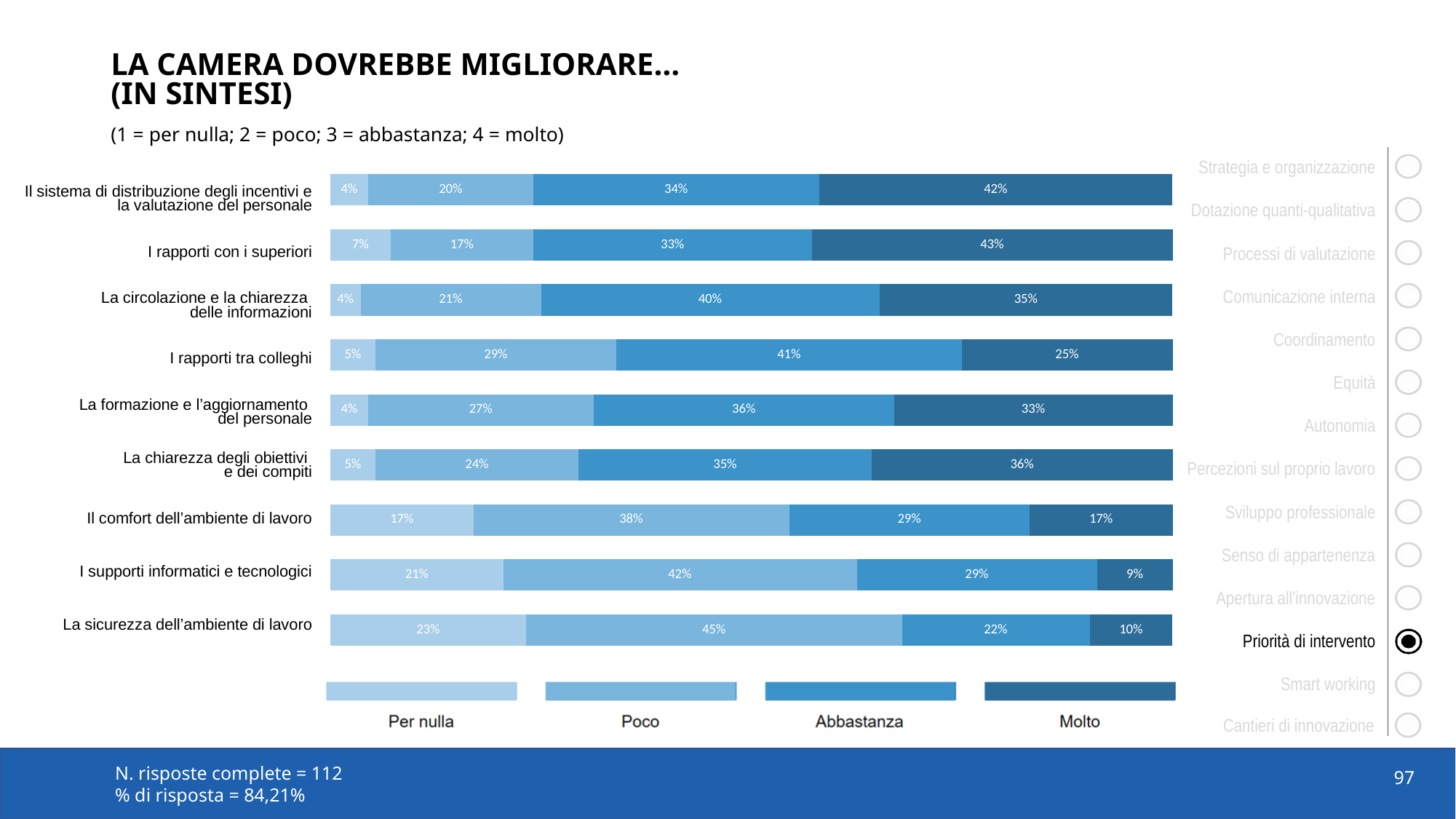
How many series does the legend list? 4 What is the total of the stacked bar for 'Il sistema di distribuzione degli incentivi e la valutazione del personale'? 100% What is the difference between the 'Molto' value for 'I rapporti con i superiori' and the 'Molto' value for 'I supporti informatici e tecnologici'? 34 percentage points What is the 'Abbastanza' value for 'La circolazione e la chiarezza delle informazioni'? 40% What is the 'Poco' value for 'La sicurezza dell'ambiente di lavoro'? 45% Which category has the highest 'Molto' value? I rapporti con i superiori Which category has the highest 'Per nulla' value? La sicurezza dell'ambiente di lavoro What is the 'Molto' value for 'I rapporti con i superiori'? 43% How many categories (items) are plotted in the chart? 9 Which category has the lowest 'Molto' value? I supporti informatici e tecnologici What kind of chart is shown on the slide? Stacked bar chart Which is larger: the 'Abbastanza' value for 'I rapporti tra colleghi' or the 'Abbastanza' value for 'Il comfort dell'ambiente di lavoro'? I rapporti tra colleghi